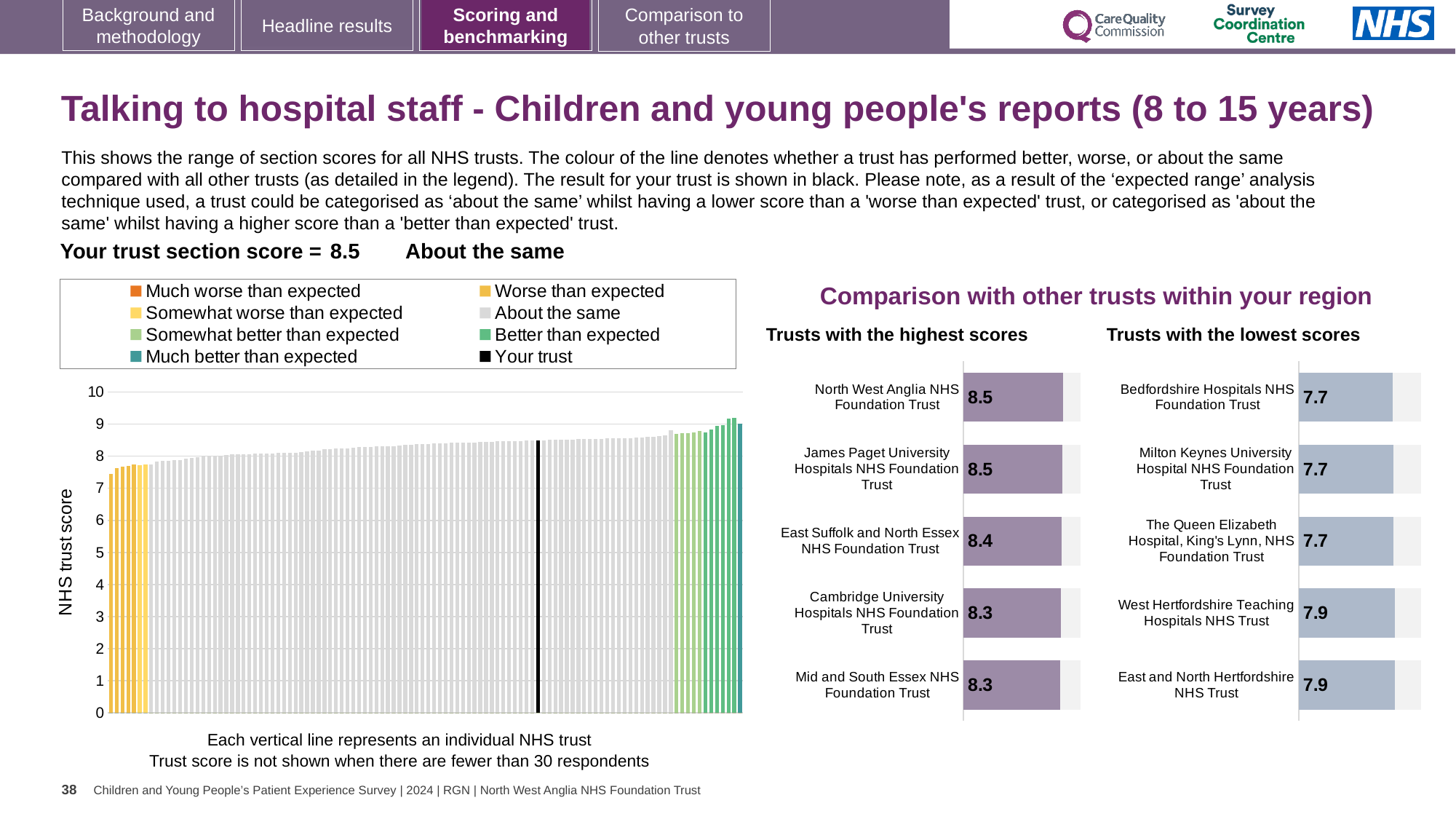
What is the difference between the score for North West Anglia NHS Foundation Trust in the 'highest scores' chart and Bedfordshire Hospitals NHS Foundation Trust in the 'lowest scores' chart? 0.8 In the main chart on the left, is the value of the leftmost bar greater or less than 8? less In the 'Trusts with the lowest scores' chart, which trust has the lowest score listed first? Bedfordshire Hospitals NHS Foundation Trust In the main chart on the left, do the trust scores rise or fall from left to right? rise In the main chart on the left, how many entries does the legend list? 8 In the main chart on the left, what is the label on the vertical axis? NHS trust score In the main chart on the left, what kind of chart is used to show the NHS trust scores? bar chart In the 'Trusts with the highest scores' chart, how many trusts are shown? 5 In the 'Trusts with the highest scores' chart, what is the difference between the scores for East Suffolk and North Essex NHS Foundation Trust and Cambridge University Hospitals NHS Foundation Trust? 0.1 In the 'Trusts with the highest scores' chart, what is the score for East Suffolk and North Essex NHS Foundation Trust? 8.4 In the 'Trusts with the lowest scores' chart, which has the larger score: West Hertfordshire Teaching Hospitals NHS Trust or Bedfordshire Hospitals NHS Foundation Trust? West Hertfordshire Teaching Hospitals NHS Trust In the 'Trusts with the lowest scores' chart, what is the score for West Hertfordshire Teaching Hospitals NHS Trust? 7.9